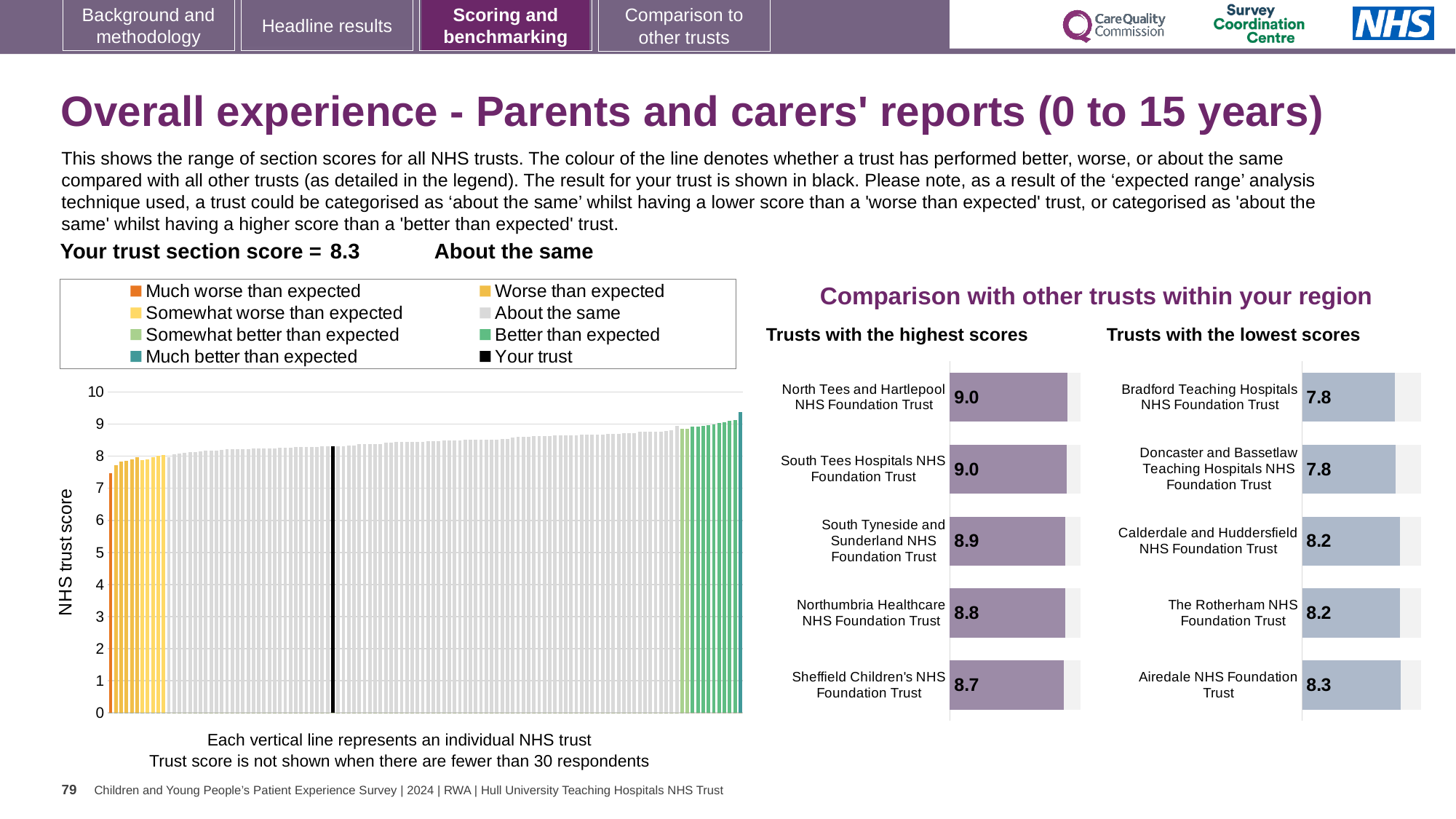
How many entries does the legend of the NHS trust score chart on the left list? 8 How many trusts are shown in the 'Trusts with the lowest scores' chart? 5 In the NHS trust score chart on the left, do the trust scores rise or fall from left to right? rise In the 'Trusts with the lowest scores' chart, what is the difference between the scores of Airedale NHS Foundation Trust and Bradford Teaching Hospitals NHS Foundation Trust? 0.5 In the NHS trust score chart on the left, what is the section score for your trust (the black bar)? 8.3 In the 'Trusts with the highest scores' chart, which trust has the lowest score? Sheffield Children's NHS Foundation Trust In the 'Trusts with the highest scores' chart, what is the score for Northumbria Healthcare NHS Foundation Trust? 8.8 In the NHS trust score chart on the left, is the value of the leftmost (orange) bar greater or less than 8? less In the 'Trusts with the lowest scores' chart, which trust has the highest score? Airedale NHS Foundation Trust In the 'Trusts with the highest scores' chart, what is the difference between the scores of North Tees and Hartlepool NHS Foundation Trust and Sheffield Children's NHS Foundation Trust? 0.3 In the 'Trusts with the lowest scores' chart, what is the score for Calderdale and Huddersfield NHS Foundation Trust? 8.2 Which has the higher score: Northumbria Healthcare NHS Foundation Trust in the highest-scores chart or The Rotherham NHS Foundation Trust in the lowest-scores chart? Northumbria Healthcare NHS Foundation Trust